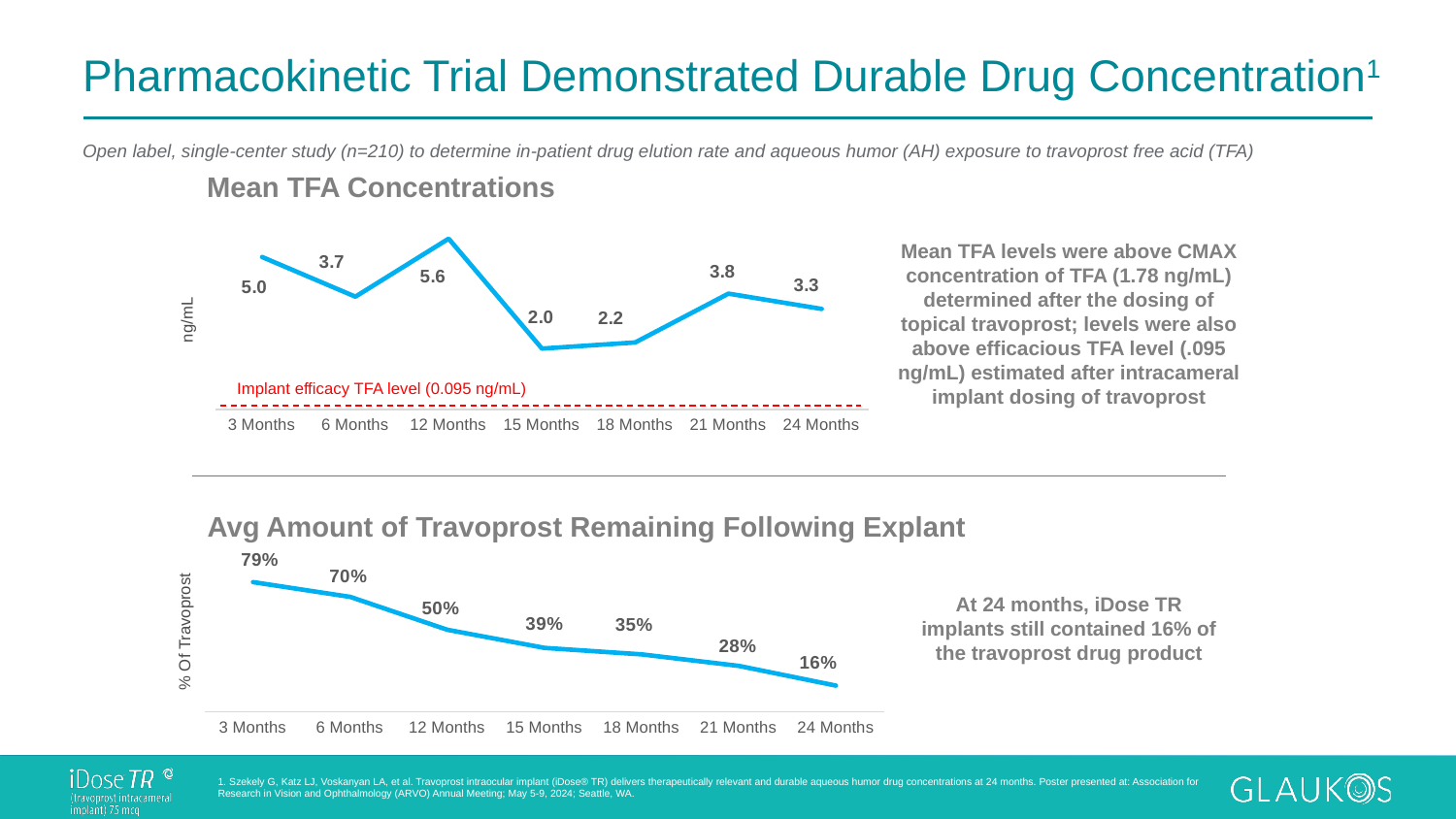
In the Mean TFA Concentrations chart, what is the value at 12 Months? 5.6 In the Avg Amount of Travoprost Remaining Following Explant chart, what is the value at 24 Months? 16% In the Mean TFA Concentrations chart, which time point has the highest value? 12 Months In the Avg Amount of Travoprost Remaining Following Explant chart, what is the value at 12 Months? 50% In the Mean TFA Concentrations chart, what is the difference between the values at 21 Months and 24 Months? 0.5 In the Mean TFA Concentrations chart, how many time points are plotted? 7 In the Avg Amount of Travoprost Remaining Following Explant chart, what is the difference between the values at 3 Months and 6 Months? 9% In the Avg Amount of Travoprost Remaining Following Explant chart, do the values rise or fall from 3 Months to 24 Months? fall In the Mean TFA Concentrations chart, which time point has the lowest value? 15 Months In the Mean TFA Concentrations chart, what implant efficacy TFA level is marked by the dashed line? 0.095 ng/mL In the Mean TFA Concentrations chart, what is the value at 3 Months? 5.0 What type of chart is the Avg Amount of Travoprost Remaining Following Explant chart? line chart